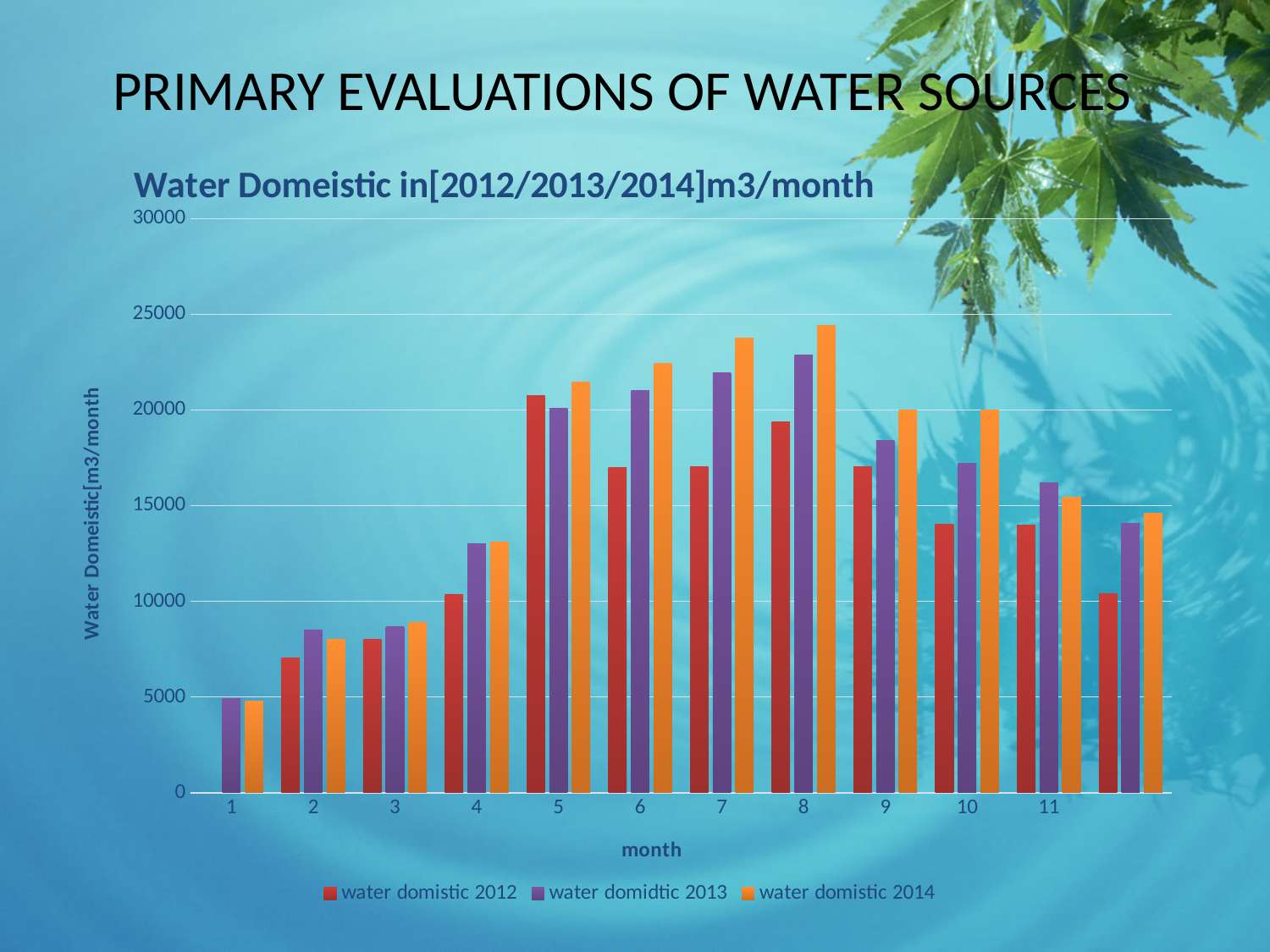
What is the label on the vertical axis? Water Domeistic[m3/month Is the value for water domistic 2012 in month 2 greater or less than 5000? greater What kind of chart is shown on the slide? bar chart Is the value for water domistic 2014 in month 7 greater or less than 20000? greater Is the value for water domidtic 2013 in month 9 greater or less than 20000? less In which month is the water domistic 2014 value highest? 8 Do the water domistic 2014 values rise or fall from month 1 to month 8? rise In month 8, which is larger: water domistic 2012 or water domistic 2014? water domistic 2014 What is the title of the chart? Water Domeistic in[2012/2013/2014]m3/month How many series does the legend list? 3